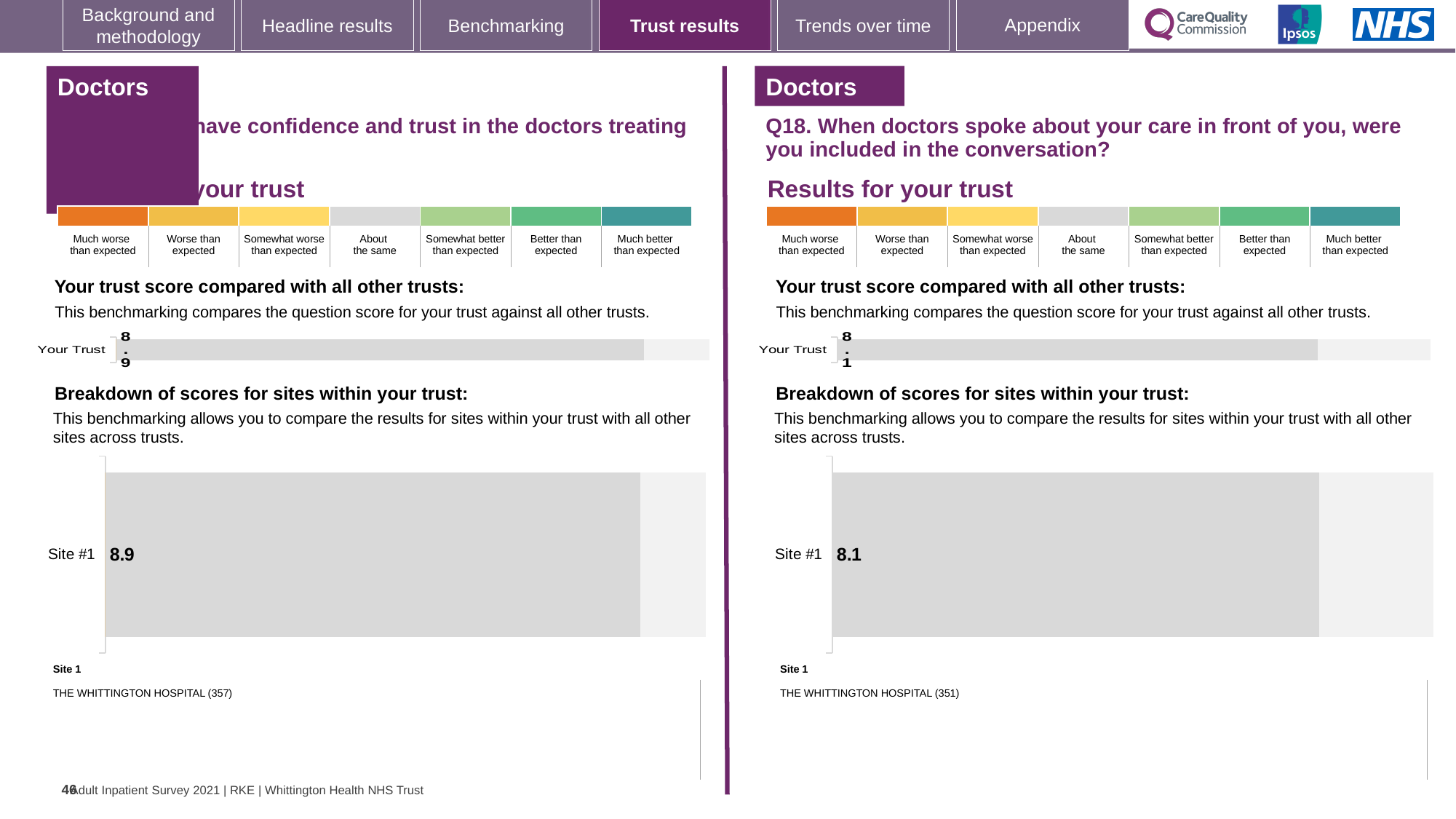
On the left half of the slide, what is the 'Your Trust' score shown in the trust benchmarking bar chart? 8.9 Which site name is listed as Site 1 beneath the right (Q18) breakdown chart? THE WHITTINGTON HOSPITAL (351) On the right half of the slide (Q18), what is the 'Your Trust' score shown in the trust benchmarking bar chart? 8.1 How many sites are plotted in the right (Q18) 'Breakdown of scores for sites within your trust' chart? 1 What is the difference between the Site #1 score in the left breakdown chart and the Site #1 score in the right (Q18) breakdown chart? 0.8 In the right 'Breakdown of scores for sites within your trust' chart (Q18), what is the score for Site #1? 8.1 How many sites are plotted in the left 'Breakdown of scores for sites within your trust' chart? 1 Which is larger: the Site #1 score in the left breakdown chart or the Site #1 score in the right (Q18) breakdown chart? The left chart (8.9) What type of chart is used to show the Site #1 score on the right half of the slide (Q18)? Bar chart What type of chart is used to show the 'Your Trust' score on the left half of the slide? Bar chart Which site name is listed as Site 1 beneath the left breakdown chart? THE WHITTINGTON HOSPITAL (357) In the left 'Breakdown of scores for sites within your trust' chart, what is the score for Site #1? 8.9